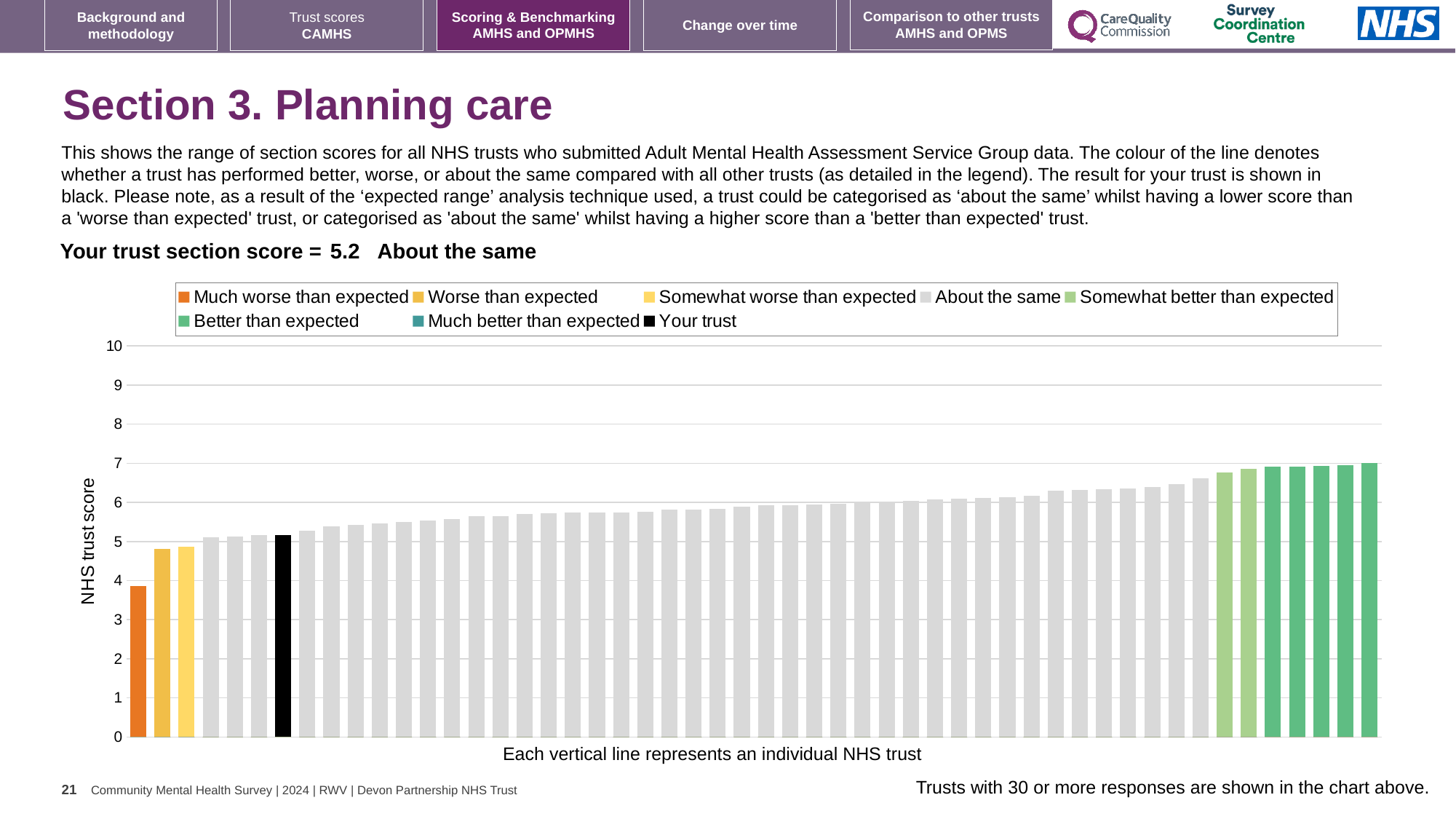
Which legend category does the highest bar in the chart belong to? Better than expected Which legend category does the lowest bar in the chart belong to? Much worse than expected How many bars are coloured as 'Much worse than expected'? 1 Do the bar values rise or fall from left to right across the chart? rise What is the section score for your trust shown on the slide? 5.2 What is the label on the vertical axis of the chart? NHS trust score What kind of chart is shown on the slide? bar chart Is the value of the lowest bar (the orange bar) greater or less than 4? less Which is larger: the value for your trust (black bar) or the value of the orange bar? your trust Is the value for your trust greater or less than 5? greater How many entries does the chart legend list? 8 Is the value of the highest bar greater or less than 6? greater